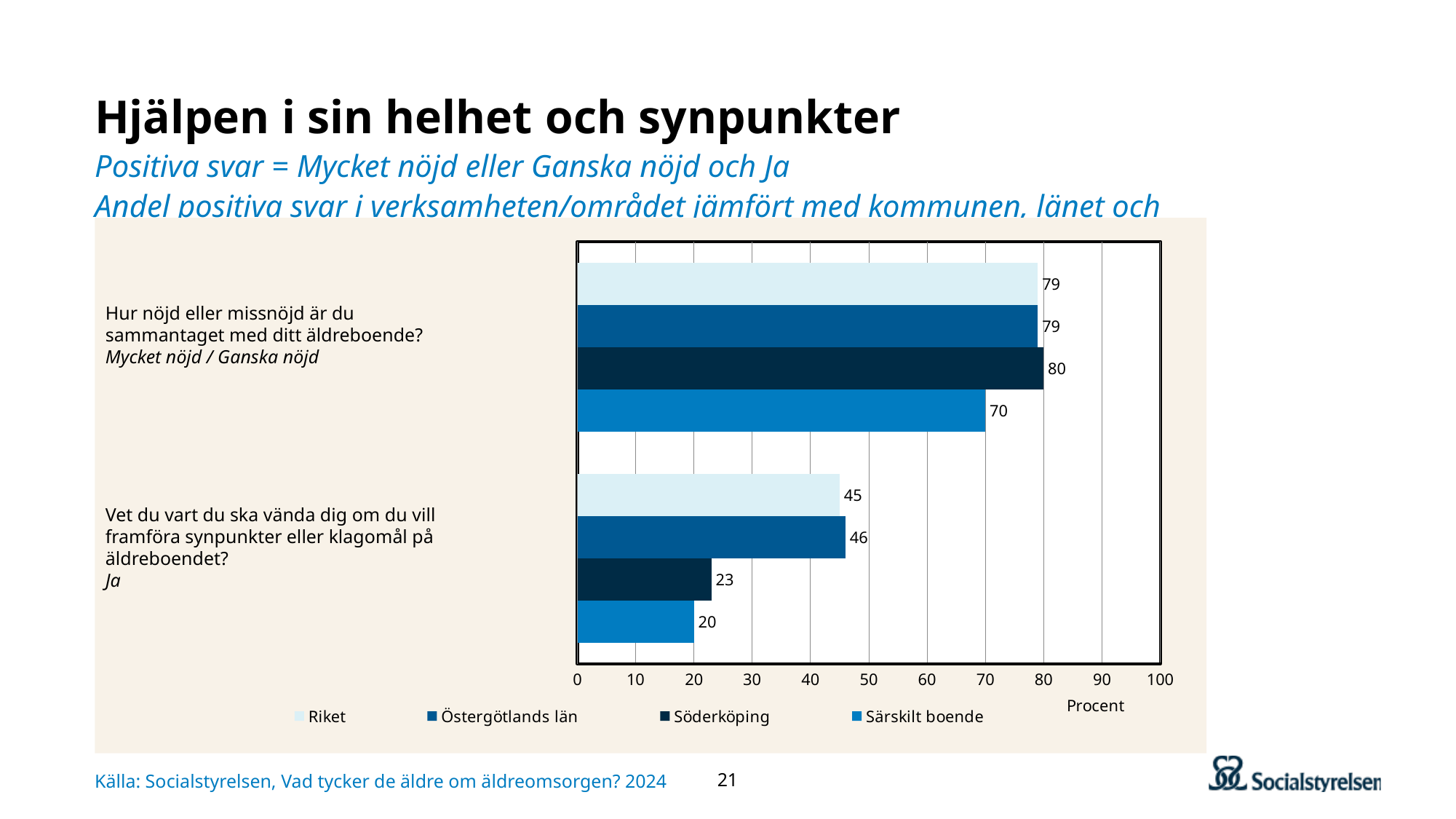
Which series has the lowest value on the question 'Vet du vart du ska vända dig om du vill framföra synpunkter eller klagomål på äldreboendet?'? Särskilt boende How many series does the legend list? 4 What is the value for Söderköping on the question 'Hur nöjd eller missnöjd är du sammantaget med ditt äldreboende?'? 80 What is the difference between Östergötlands län and Söderköping on the question 'Vet du vart du ska vända dig om du vill framföra synpunkter eller klagomål på äldreboendet?'? 23 What kind of chart is shown on the slide? bar chart What is the difference between Söderköping and Särskilt boende on the question 'Hur nöjd eller missnöjd är du sammantaget med ditt äldreboende?'? 10 On the question 'Vet du vart du ska vända dig om du vill framföra synpunkter eller klagomål på äldreboendet?', which is larger: Riket or Söderköping? Riket What unit label is shown on the x axis of the chart? Procent What is the value for Söderköping on the question 'Vet du vart du ska vända dig om du vill framföra synpunkter eller klagomål på äldreboendet?'? 23 Which series has the lowest value on the question 'Hur nöjd eller missnöjd är du sammantaget med ditt äldreboende?'? Särskilt boende What is the value for Särskilt boende on the question 'Hur nöjd eller missnöjd är du sammantaget med ditt äldreboende?'? 70 What is the value for Riket on the question 'Vet du vart du ska vända dig om du vill framföra synpunkter eller klagomål på äldreboendet?'? 45